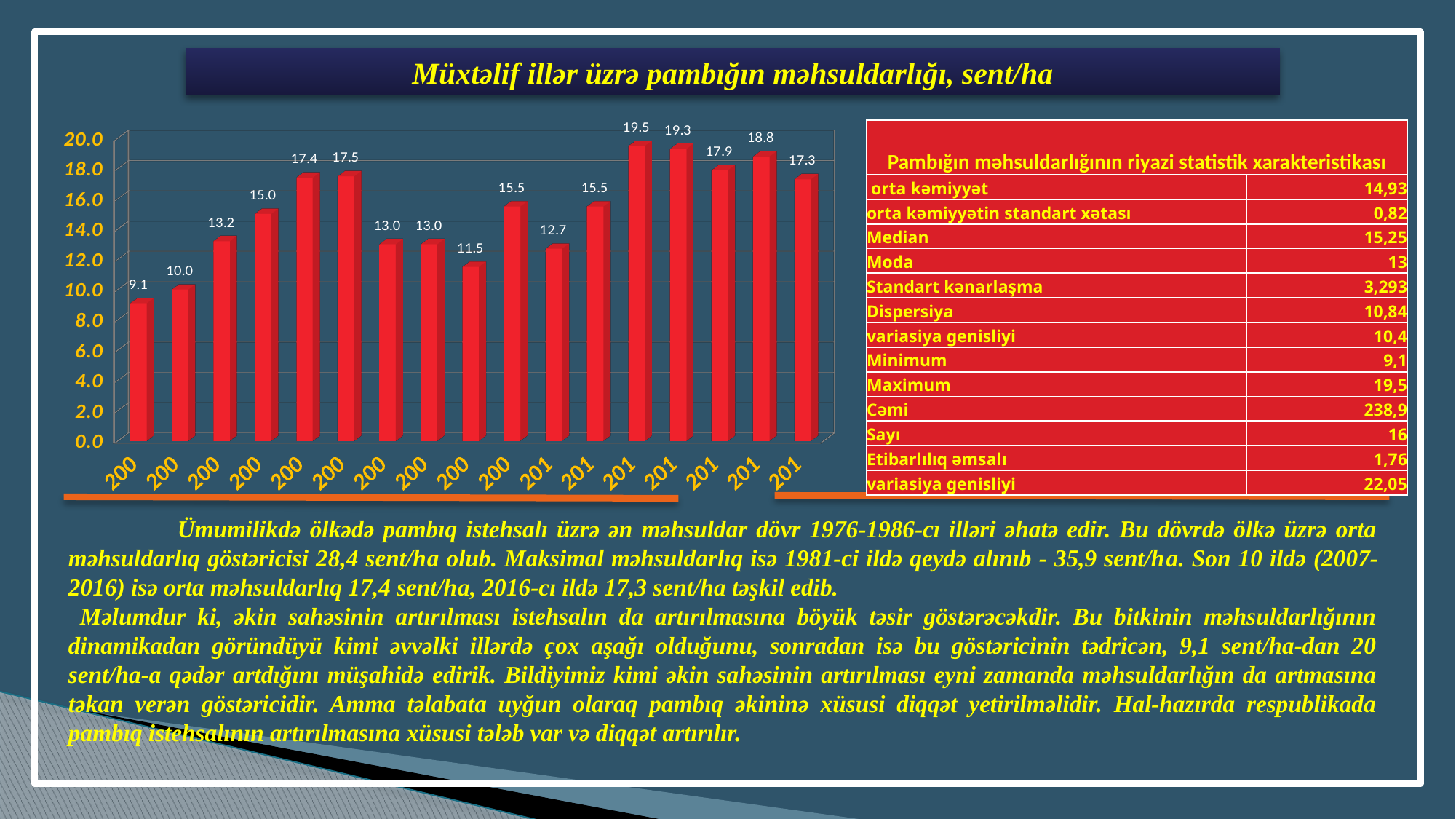
What is the highest value shown on any bar in the chart? 19.5 How many bars does the chart contain? 17 What is the difference between the highest bar value (19.5) and the lowest bar value (9.1)? 10.4 How many bars in the chart have a value above 18.0? 3 Is the value of the last (rightmost) bar greater or less than 16.0? greater What is the value of the first (leftmost) bar in the chart? 9.1 What is the lowest value shown on any bar in the chart? 9.1 What is the title of the chart? Müxtəlif illər üzrə pambığın məhsuldarlığı, sent/ha What kind of chart is shown on the slide? bar chart Overall, do the bar values rise or fall from the left of the chart to the right? rise Which is larger, the first bar or the second bar? the second bar (10.0) What is the value of the last (rightmost) bar in the chart? 17.3